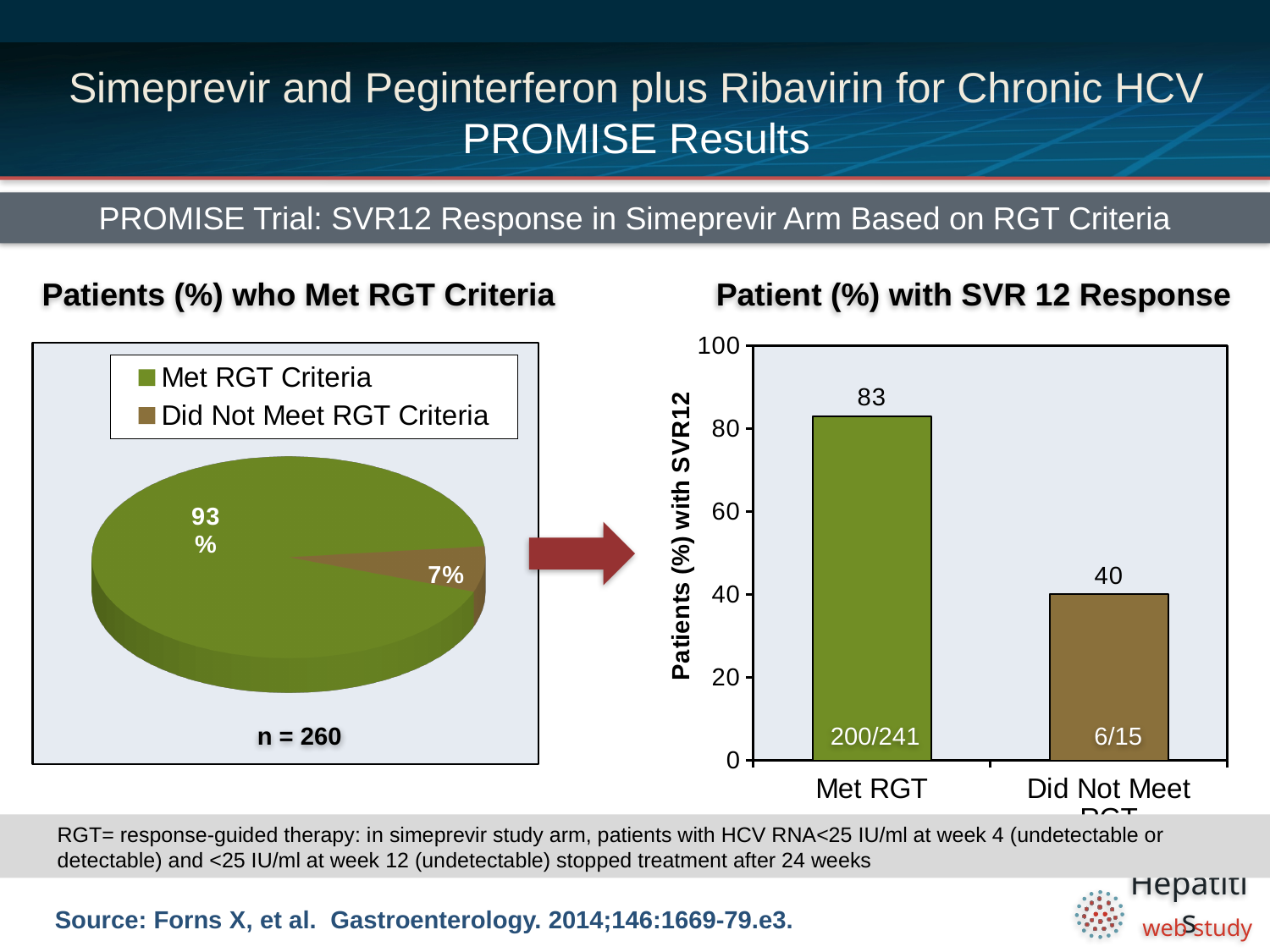
In the bar chart 'Patient (%) with SVR 12 Response', which group has the highest SVR12 rate? Met RGT In the pie chart 'Patients (%) who Met RGT Criteria', which slice is larger, Met RGT Criteria or Did Not Meet RGT Criteria? Met RGT Criteria What kind of chart is the left chart, 'Patients (%) who Met RGT Criteria'? Pie chart In the pie chart 'Patients (%) who Met RGT Criteria', what is the total number of patients (n) shown? n = 260 In the bar chart 'Patient (%) with SVR 12 Response', what is the difference in SVR12 rate between Met RGT and Did Not Meet RGT? 43 In the bar chart 'Patient (%) with SVR 12 Response', what fraction is printed inside the Met RGT bar? 200/241 In the pie chart 'Patients (%) who Met RGT Criteria', what share of patients met RGT criteria? 93% In the bar chart 'Patient (%) with SVR 12 Response', what is the SVR12 rate for patients who met RGT? 83 In the pie chart 'Patients (%) who Met RGT Criteria', what share of patients did not meet RGT criteria? 7% In the bar chart 'Patient (%) with SVR 12 Response', what is the SVR12 rate for patients who did not meet RGT? 40 In the pie chart 'Patients (%) who Met RGT Criteria', how many entries does the legend list? 2 What kind of chart is the right chart, 'Patient (%) with SVR 12 Response'? Bar chart